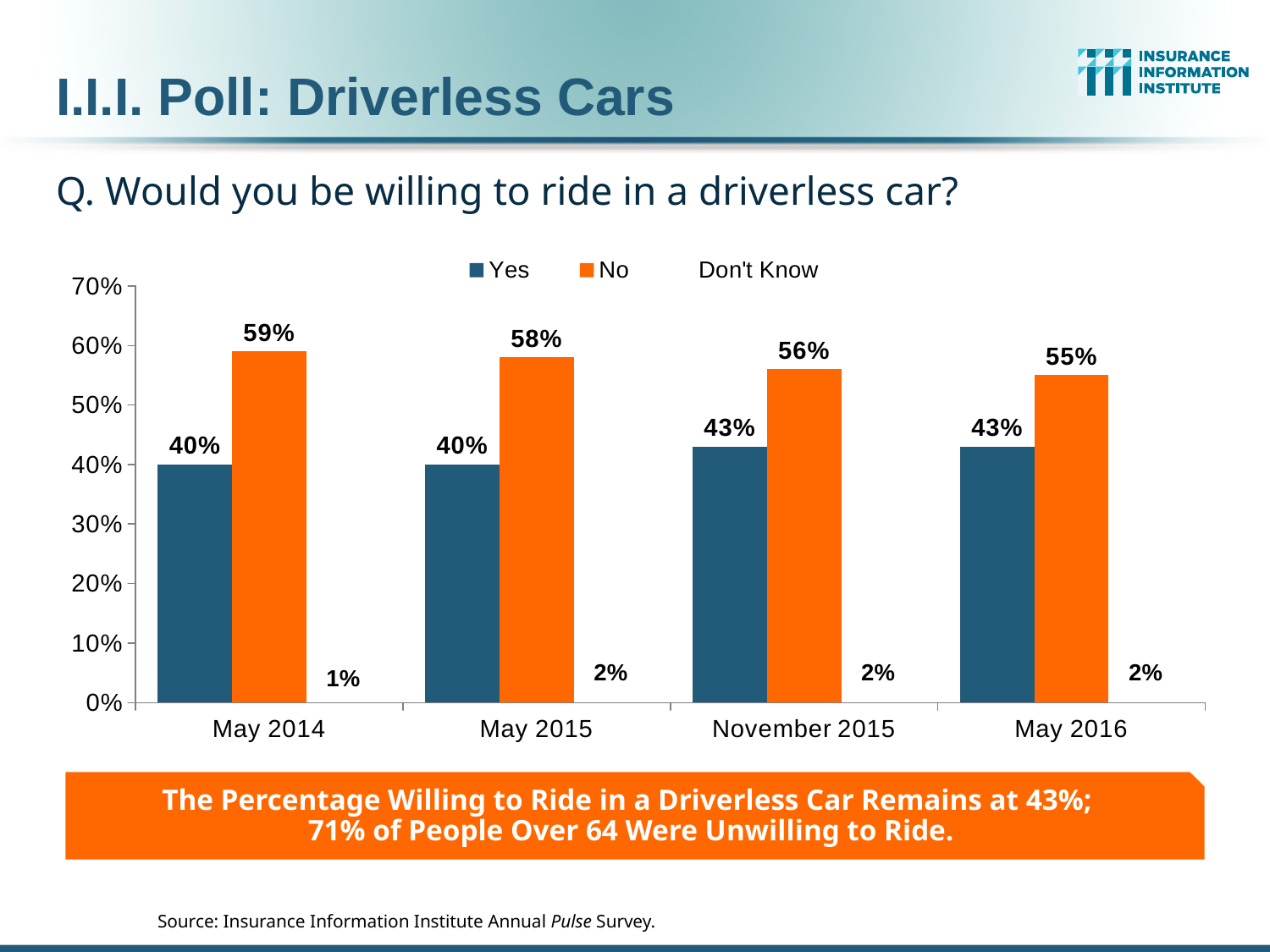
Does the "No" percentage rise or fall from May 2014 to May 2016? Fall How many series does the legend list? 3 In which survey period was the "No" response highest? May 2014 How many survey periods are shown on the x axis? 4 What is the difference between the "No" and "Yes" percentages in May 2016? 12% What percentage answered "No" in May 2014? 59% What percentage answered "Don't Know" in May 2014? 1% In which survey period was the "Don't Know" response lowest? May 2014 Which is larger in November 2015, the "Yes" or the "No" percentage? No What kind of chart is shown on the slide? Bar chart What percentage answered "Yes" in November 2015? 43% What percentage answered "Yes" in May 2015? 40%